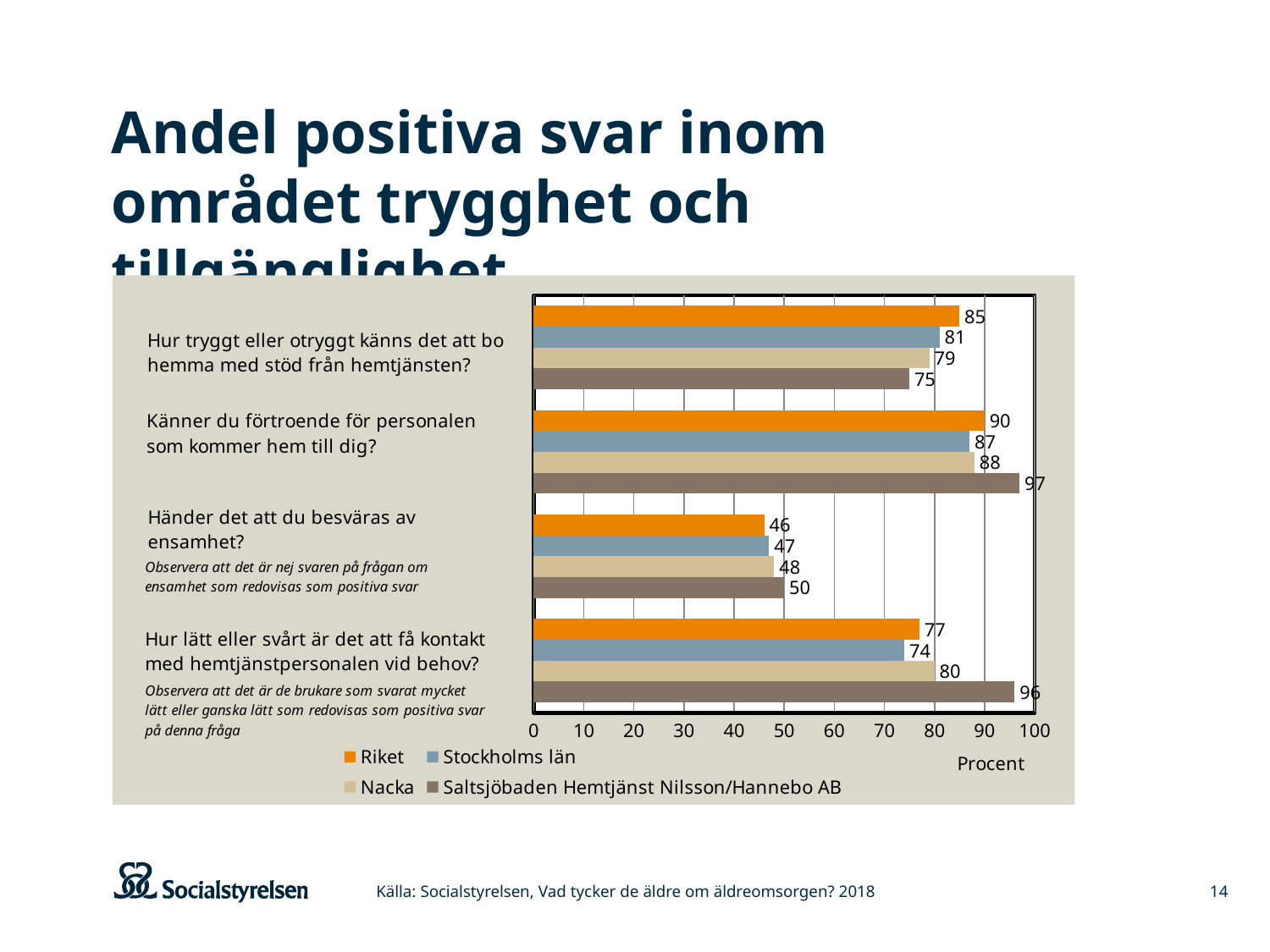
Which series has the lowest value on the question "Hur tryggt eller otryggt känns det att bo hemma med stöd från hemtjänsten?"? Saltsjöbaden Hemtjänst Nilsson/Hannebo AB How many series does the legend list? 4 What is the difference between Saltsjöbaden Hemtjänst Nilsson/Hannebo AB and Riket on the question "Känner du förtroende för personalen som kommer hem till dig?"? 7 Which series has the highest value on the question "Hur lätt eller svårt är det att få kontakt med hemtjänstpersonalen vid behov?"? Saltsjöbaden Hemtjänst Nilsson/Hannebo AB What kind of chart is shown on the slide? Bar chart What is the value for Nacka on the question "Händer det att du besväras av ensamhet?"? 48 How many question categories are plotted on the chart? 4 Which is larger on the question "Hur lätt eller svårt är det att få kontakt med hemtjänstpersonalen vid behov?": Riket or Nacka? Nacka What is the value for Saltsjöbaden Hemtjänst Nilsson/Hannebo AB on the question "Känner du förtroende för personalen som kommer hem till dig?"? 97 What is the value for Riket on the question "Hur tryggt eller otryggt känns det att bo hemma med stöd från hemtjänsten?"? 85 What unit label is shown under the x axis of the chart? Procent What is the value for Stockholms län on the question "Hur lätt eller svårt är det att få kontakt med hemtjänstpersonalen vid behov?"? 74